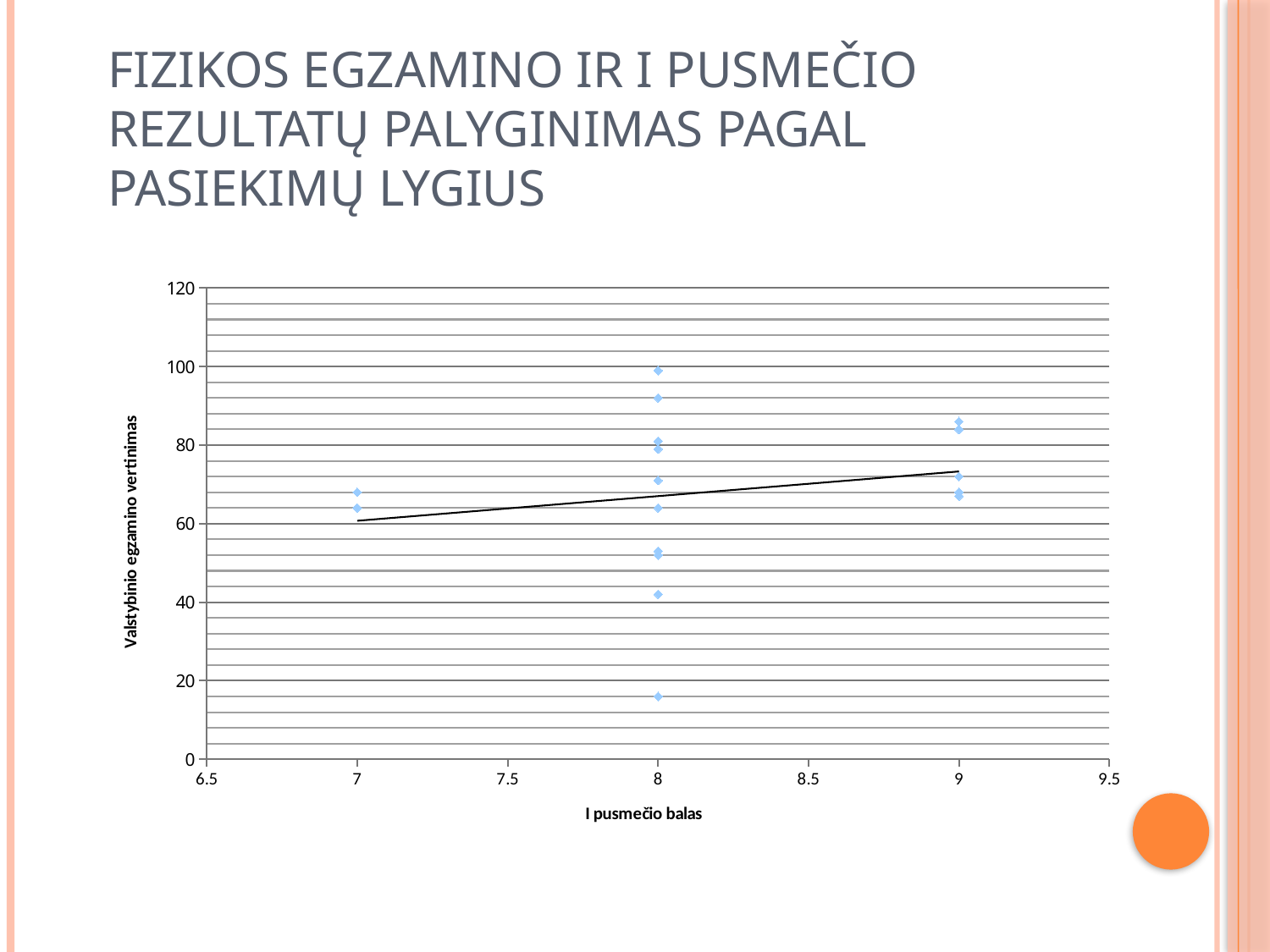
Is the lowest plotted value at I pusmečio balas 8 greater or less than 20? less What is the title of the horizontal axis of the chart? I pusmečio balas What is the title of the vertical axis of the chart? Valstybinio egzamino vertinimas At how many distinct I pusmečio balas values are data points plotted? 3 Is the highest plotted value at I pusmečio balas 9 greater or less than 80? greater What is the maximum value shown on the vertical axis of the chart? 120 Which is larger: the highest plotted value at I pusmečio balas 8 or the highest plotted value at I pusmečio balas 9? I pusmečio balas 8 Which I pusmečio balas value has the lowest plotted Valstybinio egzamino vertinimas? 8 What kind of chart is shown on the slide? scatter chart Which I pusmečio balas value has the most data points plotted? 8 Does the trendline in the chart rise or fall as the I pusmečio balas increases? rise Are the plotted values at I pusmečio balas 7 greater or less than 60? greater